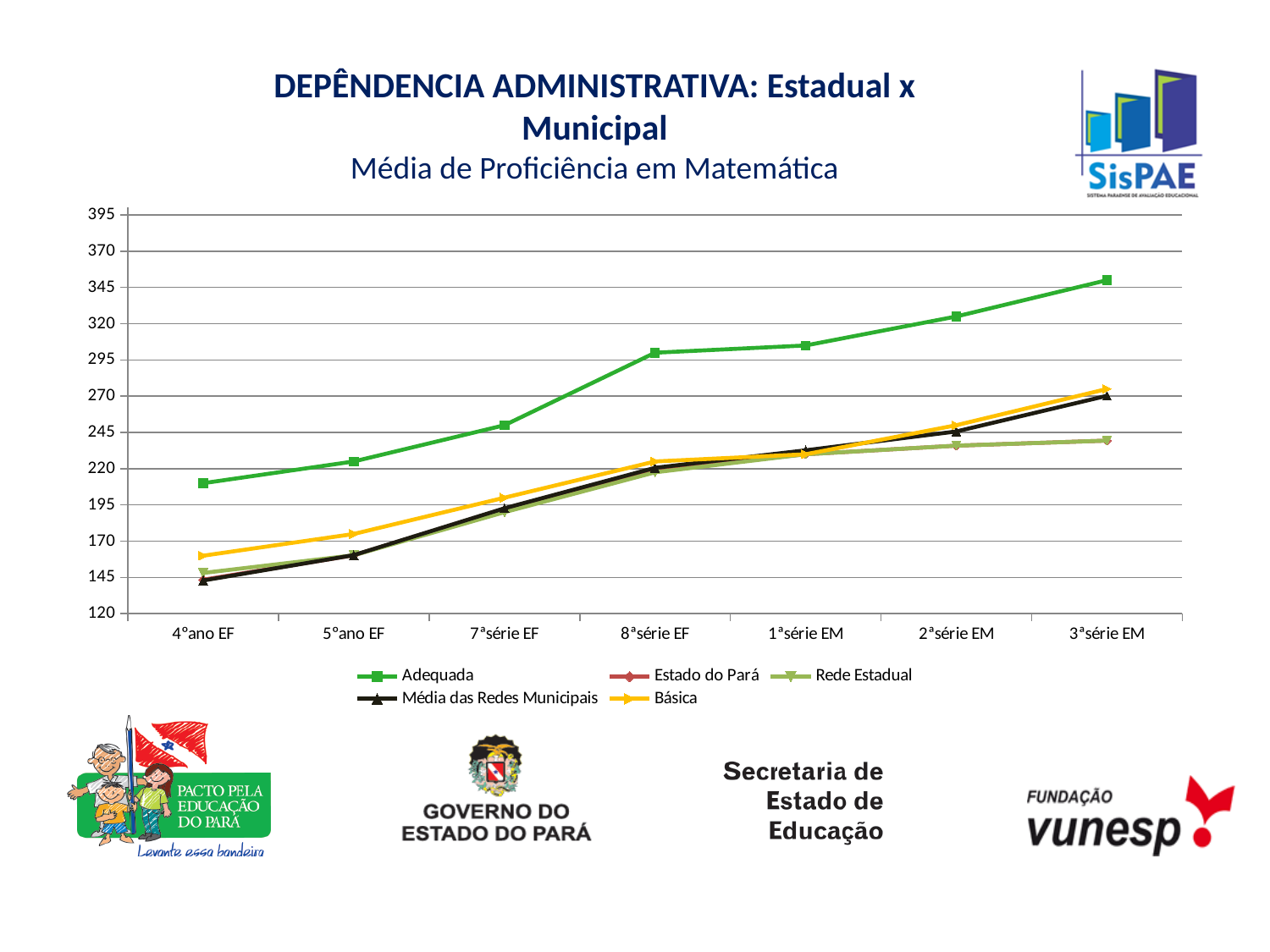
What is the subtitle of the chart below the main title? Média de Proficiência em Matemática How many series does the legend list? 5 Is the value for Básica at 4°ano EF greater or less than 170? less Which series has the highest values across all categories? Adequada For the Adequada series, which category has the highest value? 3ªsérie EM How many categories are shown along the x axis? 7 Do the values of the Adequada series rise or fall from 4°ano EF to 3ªsérie EM? Rise At 8ªsérie EF, which is larger: Adequada or Básica? Adequada Is the value for Adequada at 3ªsérie EM greater or less than 320? greater What kind of chart is shown on the slide? Line chart Is the value for Adequada at 4°ano EF greater or less than 195? greater For the Adequada series, which category has the lowest value? 4°ano EF